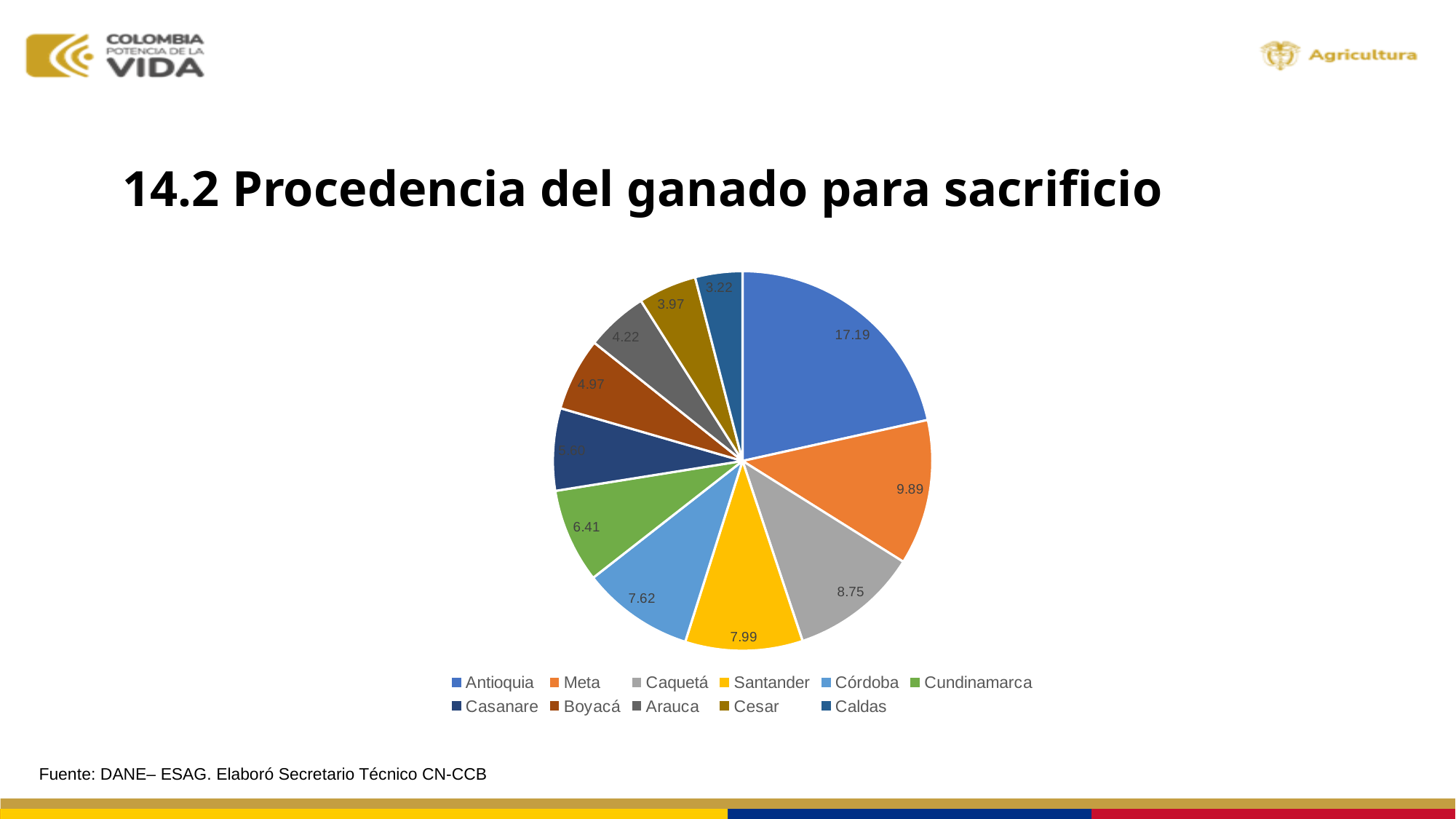
What is the value shown for Santander in the pie chart? 7.99 What is the difference between the values for Antioquia and Meta? 7.30 What is the value shown for Caldas in the pie chart? 3.22 How many departments are listed in the chart legend? 11 What is the value shown for Caquetá in the pie chart? 8.75 What is the value shown for Antioquia in the pie chart? 17.19 What is the value shown for Meta in the pie chart? 9.89 What type of chart is shown on the slide? Pie chart Which has a larger value, Córdoba or Cundinamarca? Córdoba Which department has the smallest slice in the pie chart? Caldas Which department has the largest slice in the pie chart? Antioquia What is the value shown for Boyacá in the pie chart? 4.97